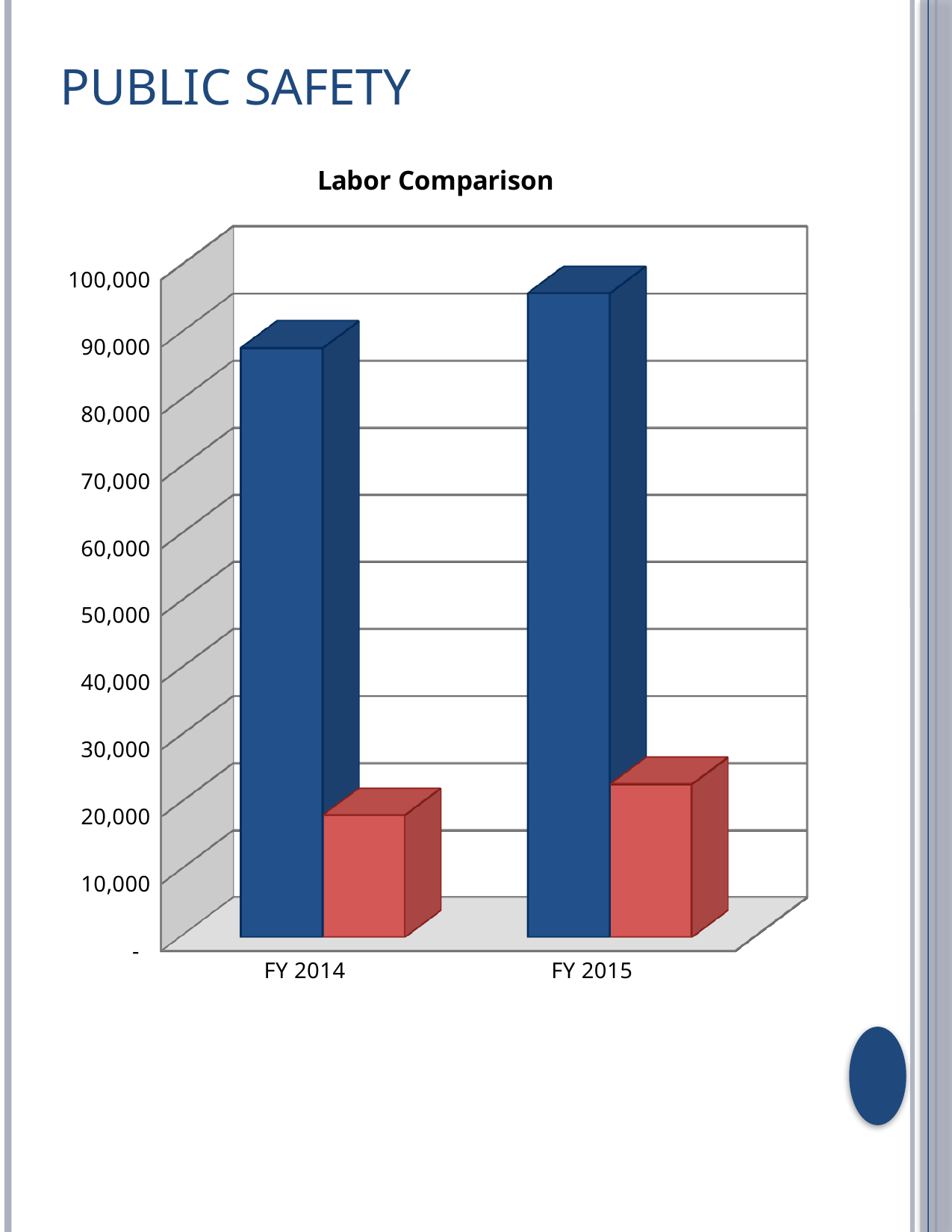
Which category has the taller red bar, FY 2014 or FY 2015? FY 2015 Which category has the taller blue bar, FY 2014 or FY 2015? FY 2015 Is the value of the blue bar for FY 2015 greater or less than 90,000? greater Is the value of the red bar for FY 2015 greater or less than 40,000? less In FY 2014, which bar is taller, the blue bar or the red bar? the blue bar Is the value of the blue bar for FY 2014 greater or less than 80,000? greater What colour are the taller bars in the Labor Comparison chart? blue What kind of chart is shown on the slide? bar chart Do the blue bars rise or fall from FY 2014 to FY 2015? rise How many categories are shown on the x axis of the Labor Comparison chart? 2 What is the title of the chart? Labor Comparison